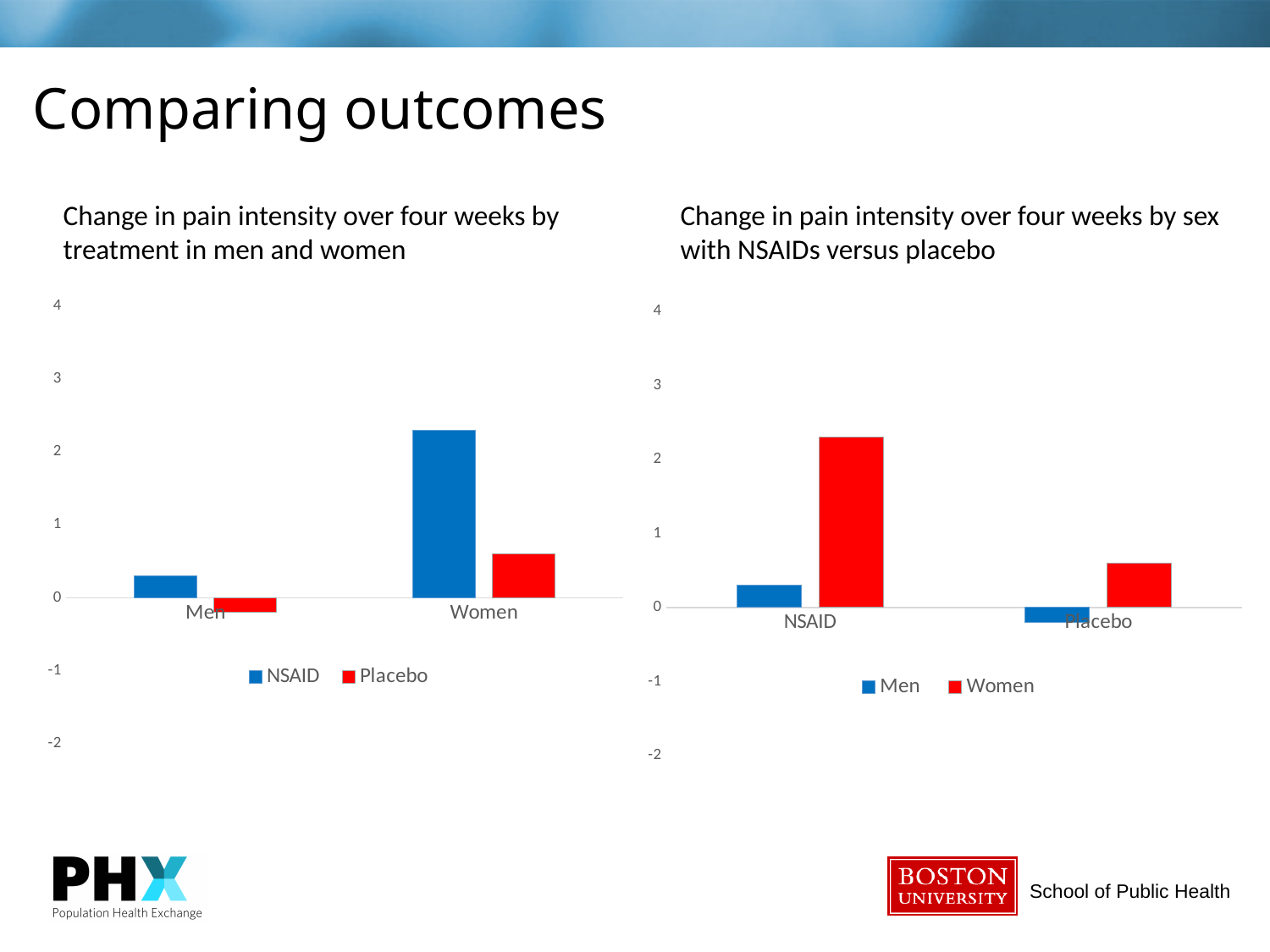
In the right chart, 'Change in pain intensity over four weeks by sex with NSAIDs versus placebo', how many series does the legend list? 2 In the left chart, 'Change in pain intensity over four weeks by treatment in men and women', what kind of chart is shown? Bar chart In the left chart, is the Placebo value for Men greater or less than 0? less In the left chart, which series is shown in red? Placebo In the left chart, how many series does the legend list? 2 In the left chart, which is larger for Women: the NSAID value or the Placebo value? NSAID In the left chart, is the Placebo value for Women greater or less than 1? less In the right chart, is the Women value for NSAID greater or less than 2? greater In the right chart, which category has the highest bar? NSAID In the left chart, how many categories are shown on the x axis? 2 In the right chart, which is larger for Placebo: the Men value or the Women value? Women